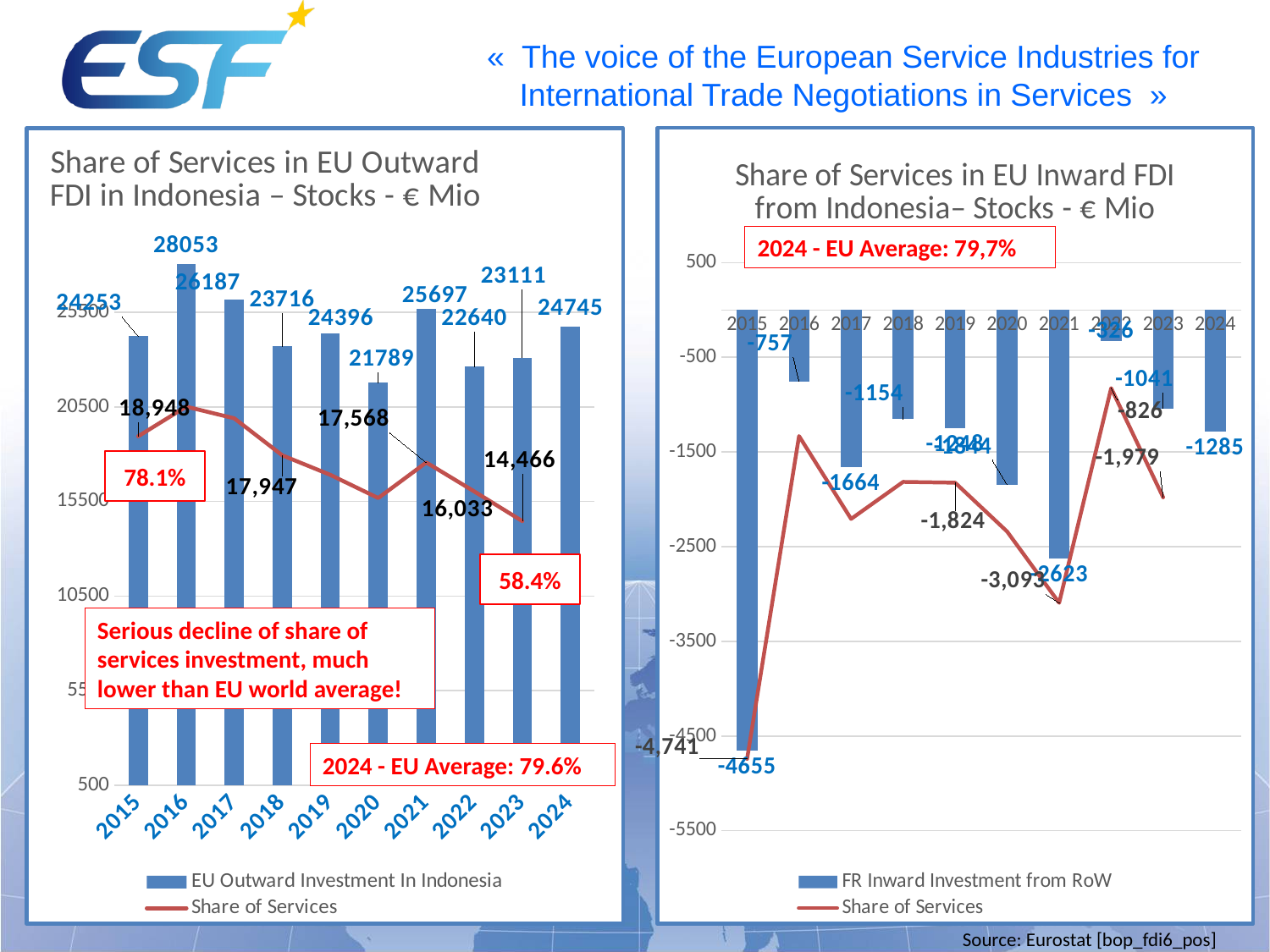
On the left chart (Share of Services in EU Outward FDI in Indonesia), what is the difference between the EU Outward Investment bars for 2016 and 2020? 6264 On the right chart (Share of Services in EU Inward FDI from Indonesia), which year has the lowest (most negative) FR Inward Investment from RoW bar? 2015 What kind of chart is the right chart (Share of Services in EU Inward FDI from Indonesia)? A bar chart combined with a line chart On the left chart (Share of Services in EU Outward FDI in Indonesia), what 2024 EU average is stated in the red text box? 79.6% On the right chart (Share of Services in EU Inward FDI from Indonesia), what is the value of the FR Inward Investment from RoW bar for 2024? -1285 On the left chart (Share of Services in EU Outward FDI in Indonesia), how many series does the legend list? 2 On the left chart (Share of Services in EU Outward FDI in Indonesia), which year has the larger EU Outward Investment bar, 2021 or 2022? 2021 On the left chart (Share of Services in EU Outward FDI in Indonesia), how many years are shown on the x axis? 10 On the left chart (Share of Services in EU Outward FDI in Indonesia), which year has the highest EU Outward Investment in Indonesia bar? 2016 On the right chart (Share of Services in EU Inward FDI from Indonesia), what is the value of the FR Inward Investment from RoW bar for 2015? -4655 On the left chart (Share of Services in EU Outward FDI in Indonesia), what is the value of EU Outward Investment in Indonesia for 2016? 28053 On the left chart (Share of Services in EU Outward FDI in Indonesia), which year has the lowest EU Outward Investment in Indonesia bar? 2020